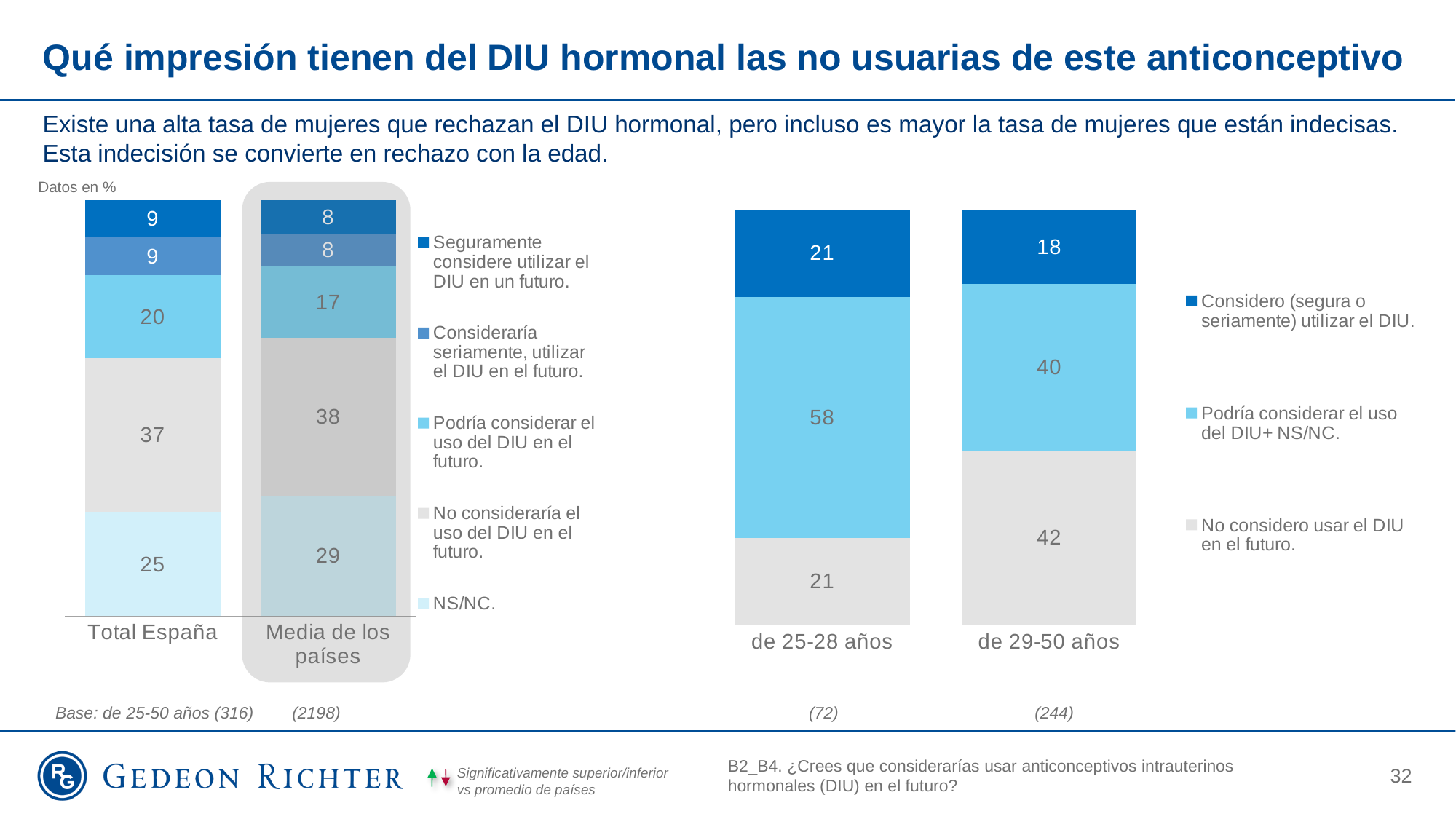
In the left chart, what is the NS/NC value for Media de los países? 29 In the right chart, what is the difference between the 'No considero usar el DIU en el futuro' values for de 29-50 años and de 25-28 años? 21 In the right chart, what is the total of the stacked bar for de 25-28 años? 100 In the right chart, how many categories are shown on the x axis? 2 In the left chart, which bar has the larger NS/NC value, Total España or Media de los países? Media de los países In the left chart, how many series does the legend list? 5 In the right chart, what is the value for 'Podría considerar el uso del DIU+ NS/NC' for de 25-28 años? 58 In the left chart, what is the value for 'Podría considerar el uso del DIU en el futuro' for Total España? 20 In the right chart, what is the value for 'Considero (segura o seriamente) utilizar el DIU' for de 29-50 años? 18 What kind of chart is the right chart? Stacked bar chart In the left chart, what is the value for 'No consideraría el uso del DIU en el futuro' for Total España? 37 In the left chart, what is the difference between the 'No consideraría' values for Media de los países and Total España? 1